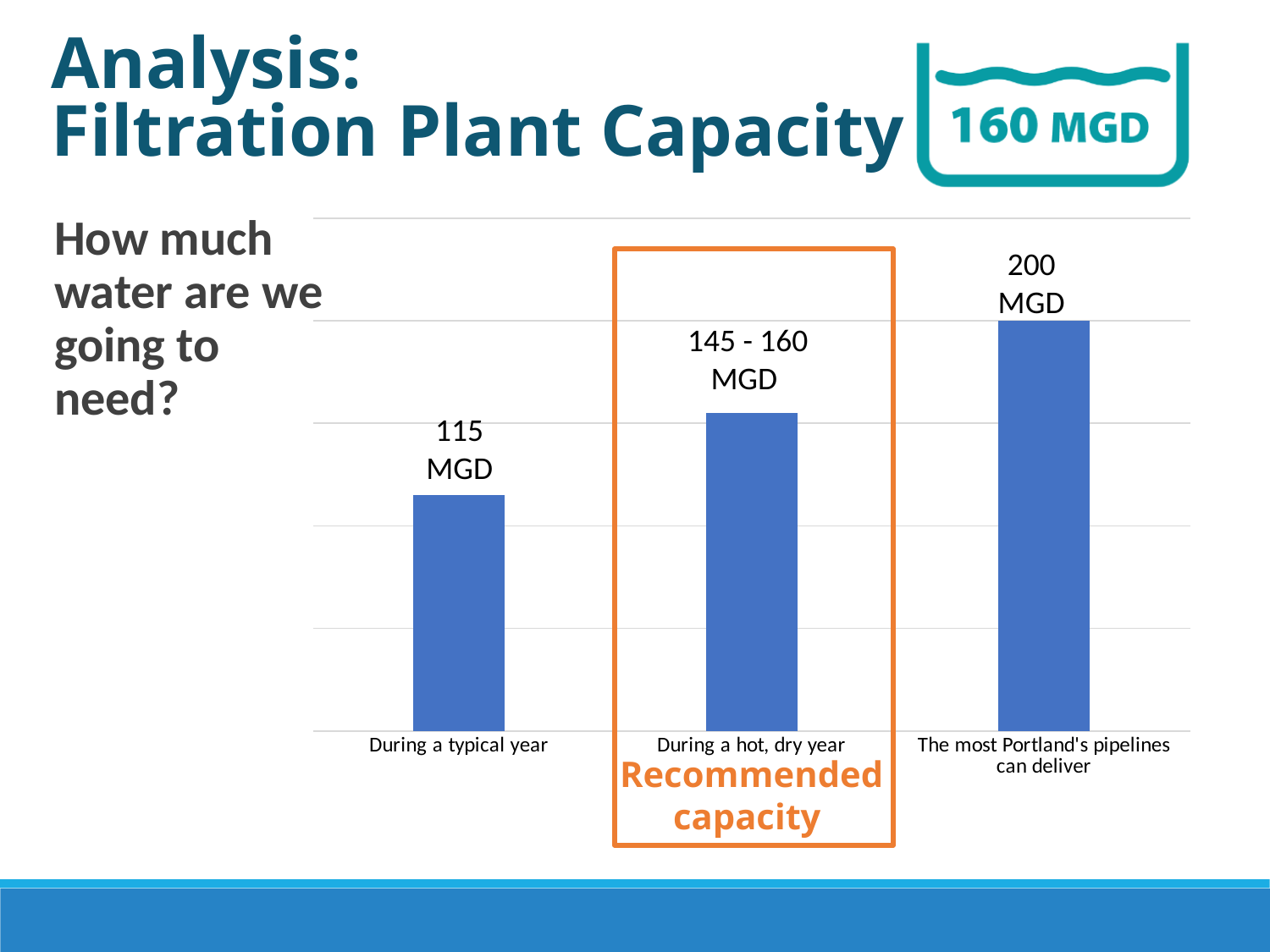
What is the value shown for 'During a typical year'? 115 MGD What kind of chart is shown on the slide? Bar chart Which category has the highest bar? The most Portland's pipelines can deliver How much larger is the value for 'The most Portland's pipelines can deliver' than the value for 'During a typical year'? 85 MGD What value is labelled on the bar for 'During a hot, dry year'? 145 - 160 MGD Do the bar values rise or fall from left to right across the chart? Rise Which category is highlighted with an orange box labelled 'Recommended capacity'? During a hot, dry year How many bars are plotted in the chart? 3 What is the value shown for 'The most Portland's pipelines can deliver'? 200 MGD Which category has the lowest bar? During a typical year What is the title of the slide containing the chart? Analysis: Filtration Plant Capacity Which is larger: the bar for 'During a typical year' or the bar for 'During a hot, dry year'? During a hot, dry year